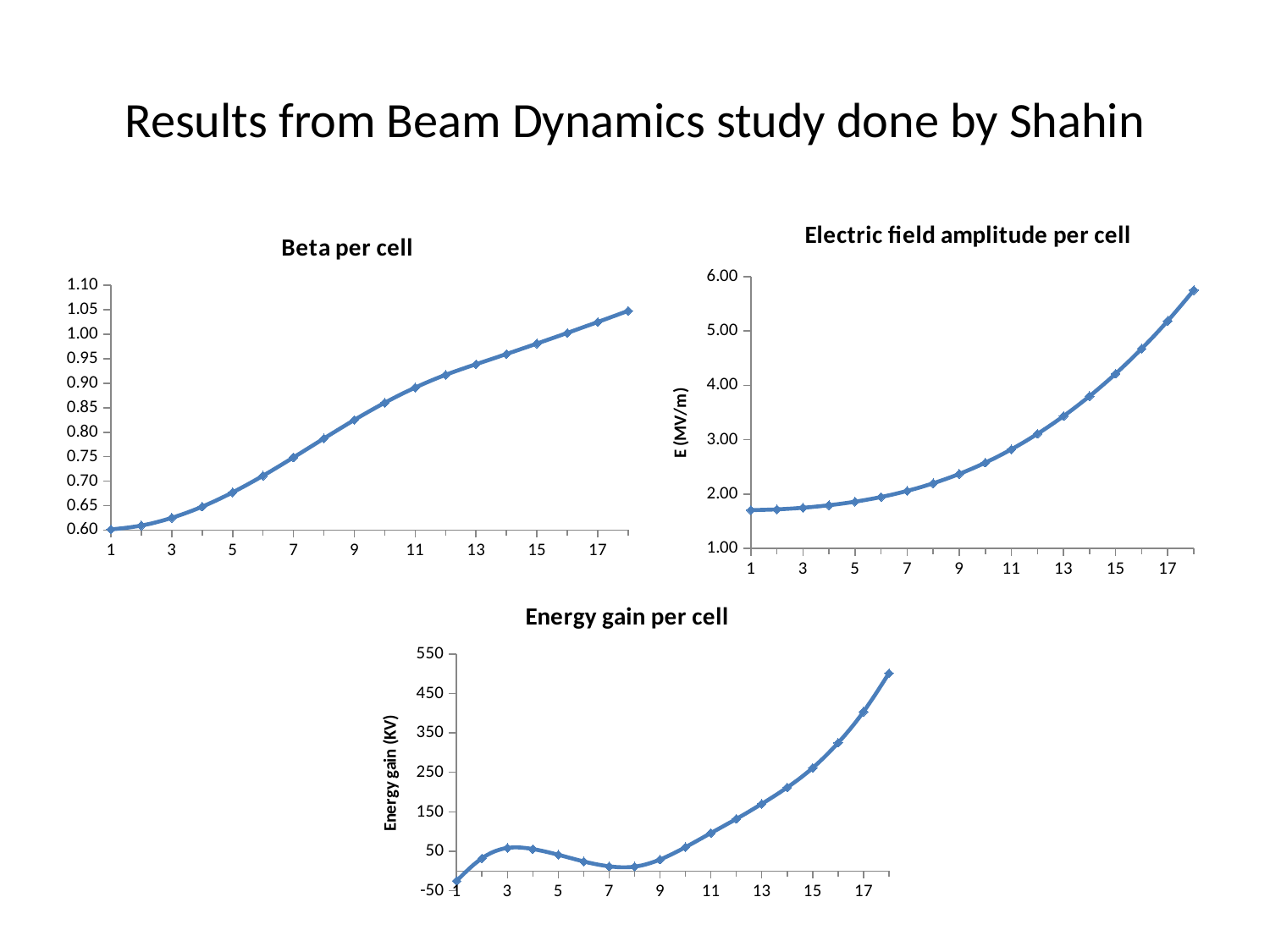
In the 'Energy gain per cell' chart, is the value at cell 17 greater or less than 350? greater What is the y-axis label of the 'Electric field amplitude per cell' chart? E (MV/m) In the 'Electric field amplitude per cell' chart, is the value at cell 5 greater or less than 2.00? less In the 'Beta per cell' chart, is the value at cell 17 greater or less than 1.00? greater In the 'Energy gain per cell' chart, at which cell is the energy gain highest? 18 In the 'Electric field amplitude per cell' chart, do the values rise or fall along the x axis? rise In the 'Energy gain per cell' chart, which has the larger value, cell 3 or cell 8? cell 3 What kind of chart is the 'Beta per cell' chart? line chart In the 'Beta per cell' chart, do the values rise or fall as the cell number increases? rise